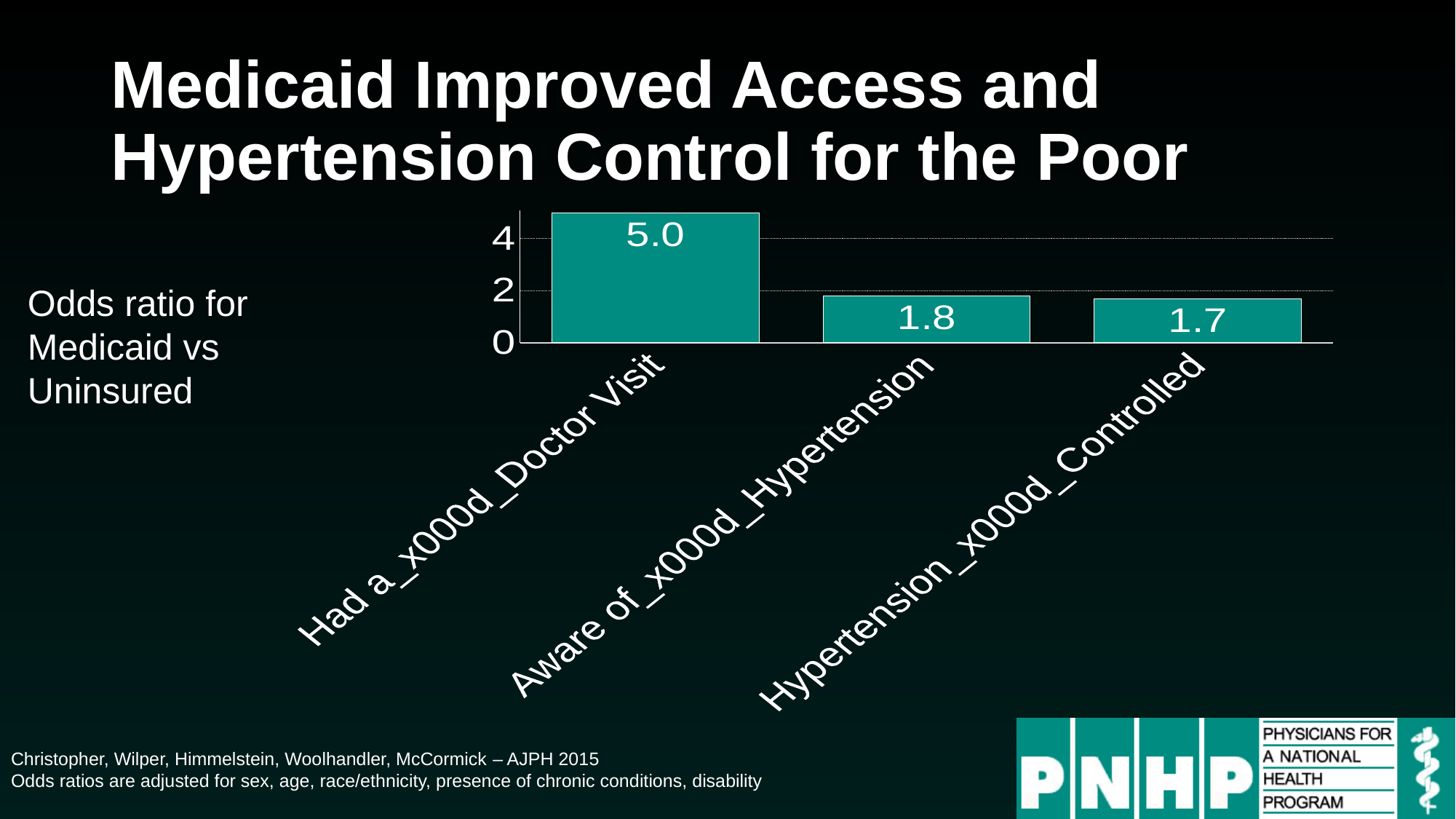
Which is larger, the odds ratio for Aware of Hypertension or for Hypertension Controlled? Aware of Hypertension What is the odds ratio shown for Had a Doctor Visit? 5.0 What is the odds ratio shown for Hypertension Controlled? 1.7 What is the difference between the odds ratio for Aware of Hypertension and the odds ratio for Hypertension Controlled? 0.1 What kind of chart is shown on the slide? Bar chart What is the odds ratio shown for Aware of Hypertension? 1.8 How many categories are plotted in the chart? 3 Is the value for Hypertension Controlled greater or less than 2? less Which category has the highest odds ratio? Had a Doctor Visit Is the value for Had a Doctor Visit greater or less than 4? greater Which category has the lowest odds ratio? Hypertension Controlled What is the difference between the odds ratio for Had a Doctor Visit and the odds ratio for Aware of Hypertension? 3.2